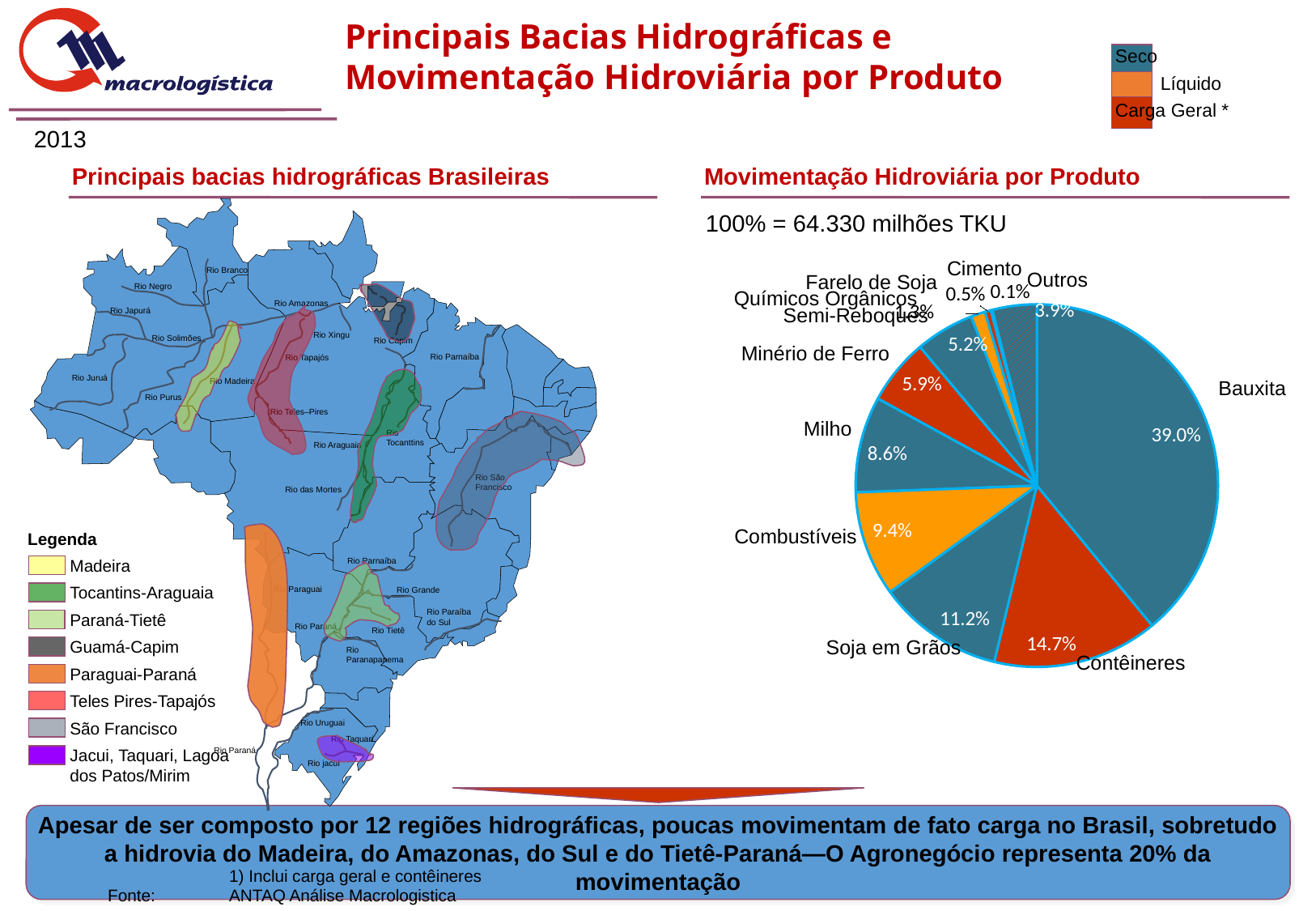
In the 'Movimentação Hidroviária por Produto' pie chart, what share does Minério de Ferro have? 5.9% In the 'Movimentação Hidroviária por Produto' pie chart, what share does Bauxita have? 39.0% In the 'Movimentação Hidroviária por Produto' pie chart, what share does Soja em Grãos have? 11.2% According to the 'Movimentação Hidroviária por Produto' chart, what total does 100% correspond to? 64.330 milhões TKU How many series does the legend at the top right of the slide list? 3 In the 'Movimentação Hidroviária por Produto' pie chart, what is the difference in percentage points between Bauxita and Contêineres? 24.3 percentage points In the 'Movimentação Hidroviária por Produto' pie chart, what share does Contêineres have? 14.7% What kind of chart is the 'Movimentação Hidroviária por Produto' chart? pie chart In the 'Movimentação Hidroviária por Produto' pie chart, which product has the largest share? Bauxita In the 'Movimentação Hidroviária por Produto' pie chart, which is larger: Milho or Combustíveis? Combustíveis In the 'Movimentação Hidroviária por Produto' pie chart, what share does Combustíveis have? 9.4% In the 'Movimentação Hidroviária por Produto' pie chart, what share does Semi-Reboques have? 5.2%